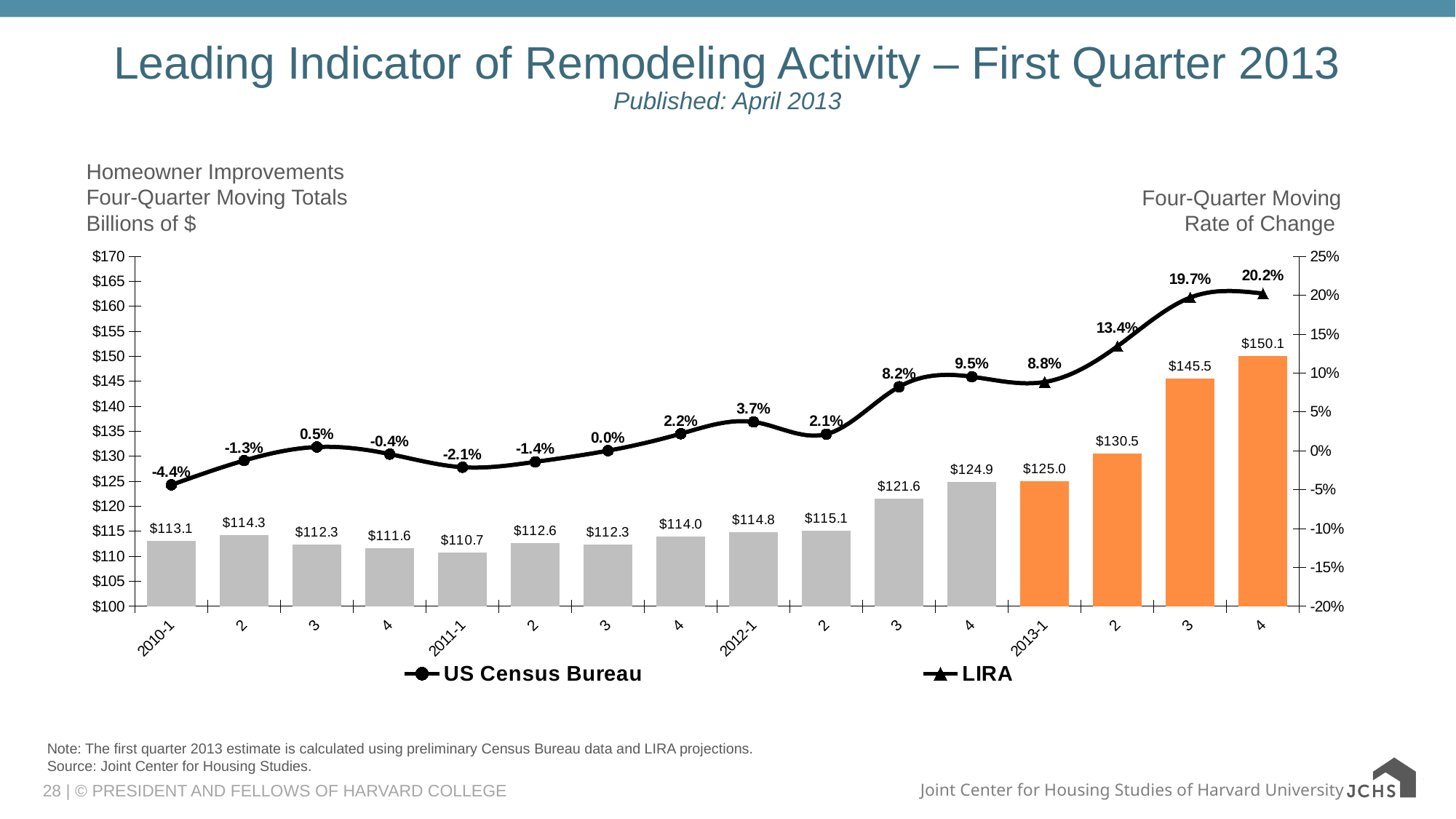
What are the two series named in the legend? US Census Bureau and LIRA Which quarter has the lowest four-quarter moving rate of change? 2010-1 What is the four-quarter moving total (billions of $) shown for 2011-1? $110.7 How many series does the legend list? 2 Do the bar values rise or fall from 2012-2 to 2013-4? Rise How many quarters are shown on the x axis? 16 What kind of chart is this? A bar chart combined with a line chart Which quarter has the highest bar value? 2013-4 Which has the larger bar value, 2012-3 or 2012-4? 2012-4 What is the difference between the bar values for 2013-4 and 2013-3? $4.6 Which quarter has the lowest bar value? 2011-1 What four-quarter moving rate of change is labeled for 2012-1? 3.7%